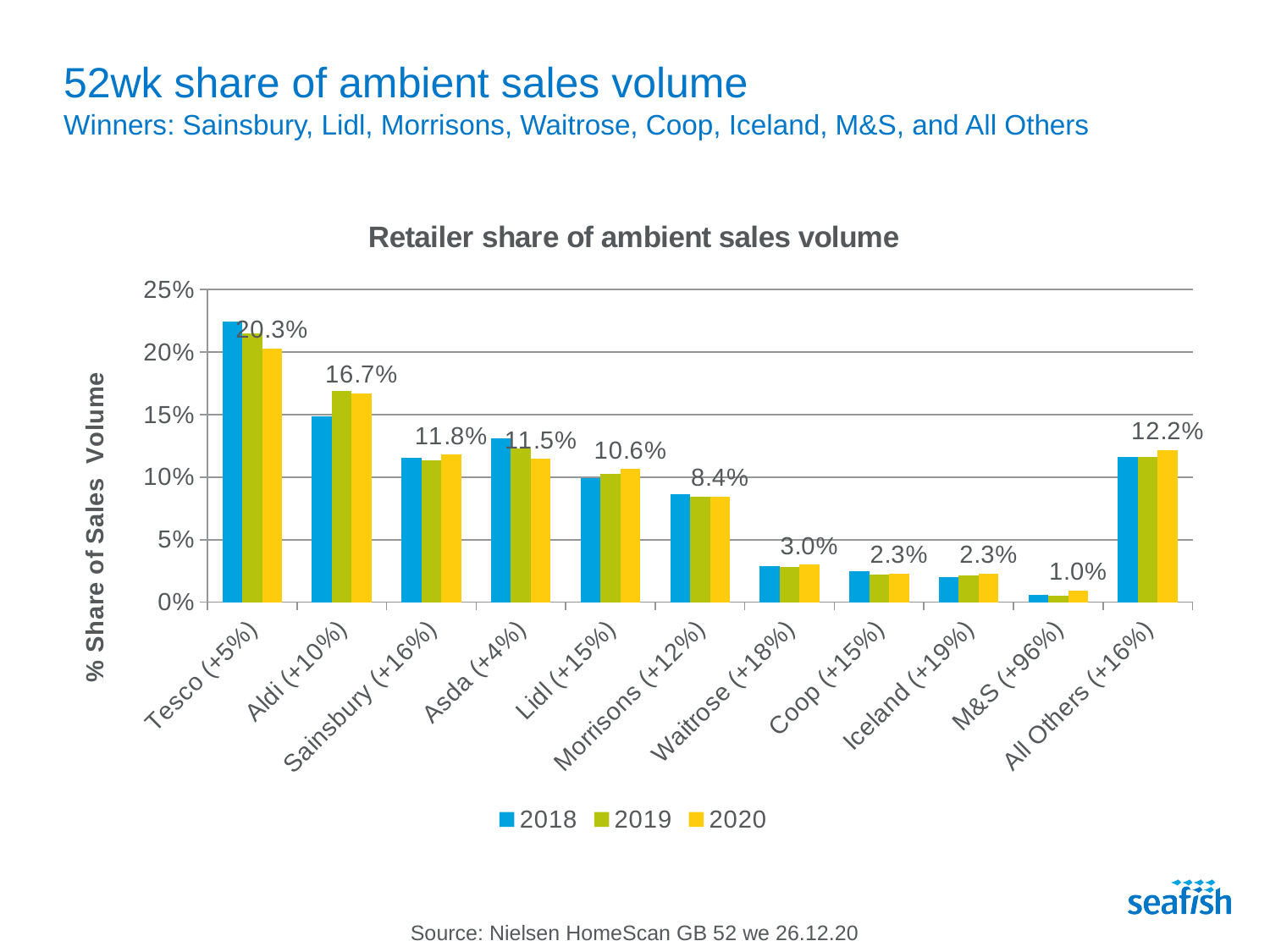
Is the 2018 value for Tesco (+5%) greater or less than 20%? greater Which retailer has the lowest 2020 share of ambient sales volume? M&S (+96%) How many retailer categories are shown on the x axis? 11 Which has a larger 2020 value, Lidl (+15%) or Morrisons (+12%)? Lidl (+15%) Which retailer has the highest 2020 share of ambient sales volume? Tesco (+5%) What is the 2020 value for Aldi (+10%)? 16.7% How many series does the legend list? 3 Do the values for Tesco (+5%) rise or fall from 2018 to 2020? fall What is the difference between the 2020 values for Tesco (+5%) and Aldi (+10%)? 3.6% What is the 2020 value for M&S (+96%)? 1.0% What is the 2020 value for All Others (+16%)? 12.2% What is the 2020 value for Tesco (+5%)? 20.3%